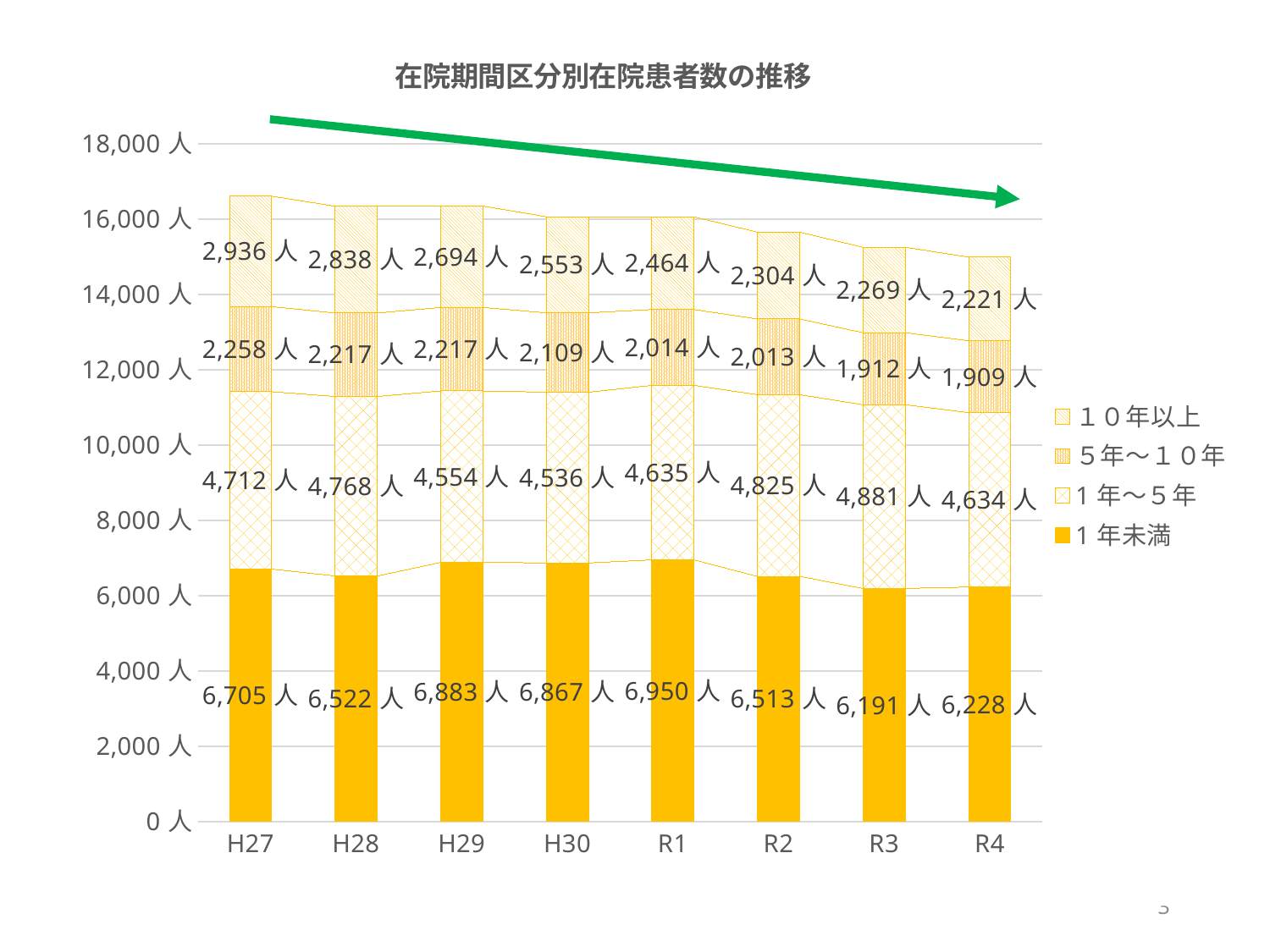
How many series does the legend list? 4 What is the total of the stacked bar for R4? 14,992人 Which is larger, the 1年未満 value for H29 or for H30? H29 What is the difference between the 10年以上 values for H27 and R4? 715人 Which year has the highest value for 1年～5年? R3 Which year has the lowest value for 1年未満? R3 Do the 10年以上 values rise or fall from H27 to R4? Fall What is the value for 5年～10年 in R4? 1,909人 What is the value for 1年未満 in R1? 6,950人 What is the value for 10年以上 in H27? 2,936人 How many years are shown on the x axis? 8 What kind of chart is this? Stacked bar chart